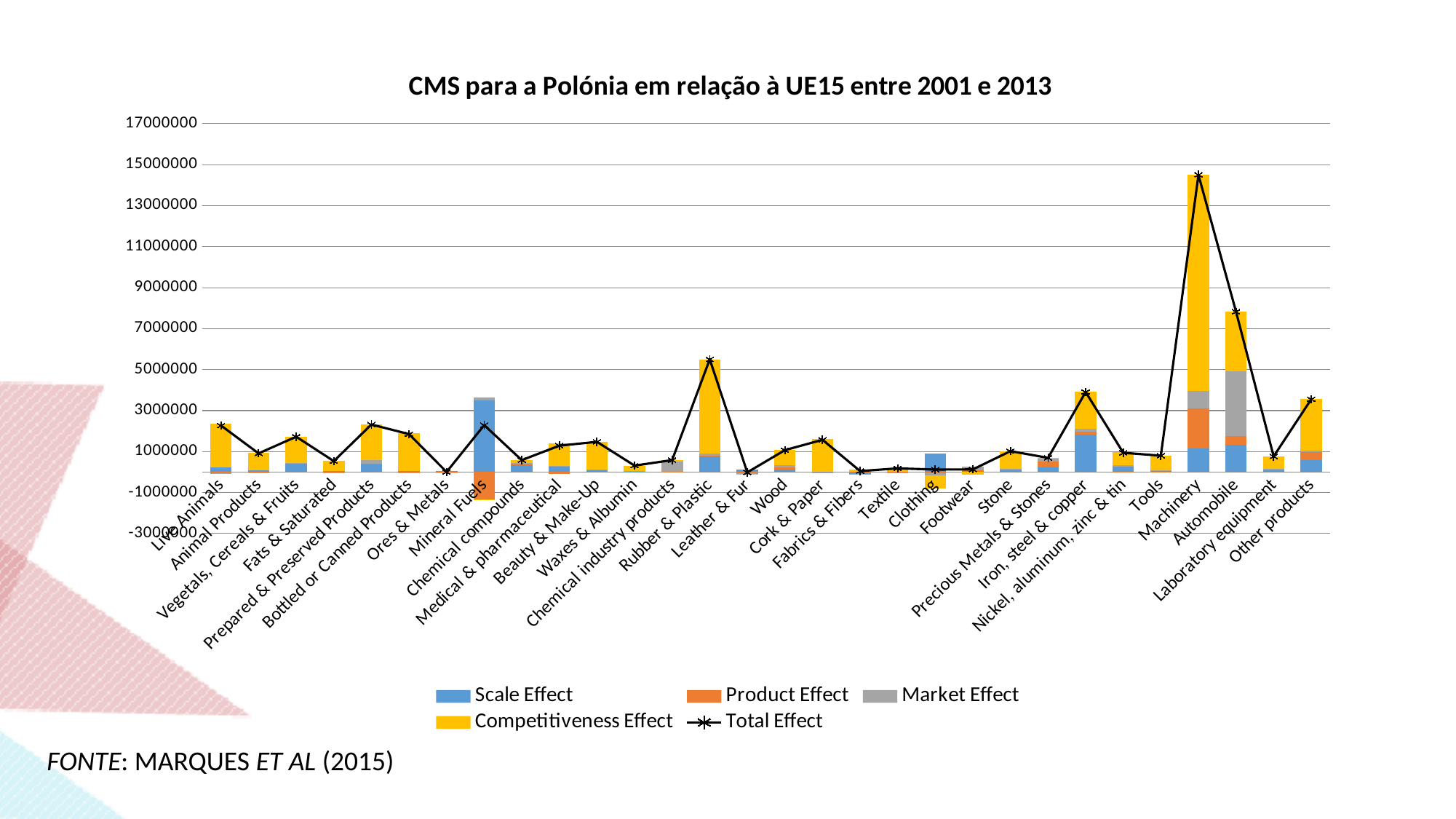
How many product categories are shown on the x axis? 30 Which has the larger Total Effect, Machinery or Automobile? Machinery Is the Total Effect for Automobile greater or less than 7000000? greater Is the Total Effect for Machinery greater or less than 13000000? greater What kind of chart is shown on the slide? Stacked bar chart with a line What is the title of the chart? CMS para a Polónia em relação à UE15 entre 2001 e 2013 Is the Total Effect for Rubber & Plastic greater or less than 5000000? greater Which category has the highest Total Effect? Machinery Which category has the largest Scale Effect bar? Mineral Fuels How many series does the legend list? 5 Which series is shown in yellow in the legend? Competitiveness Effect